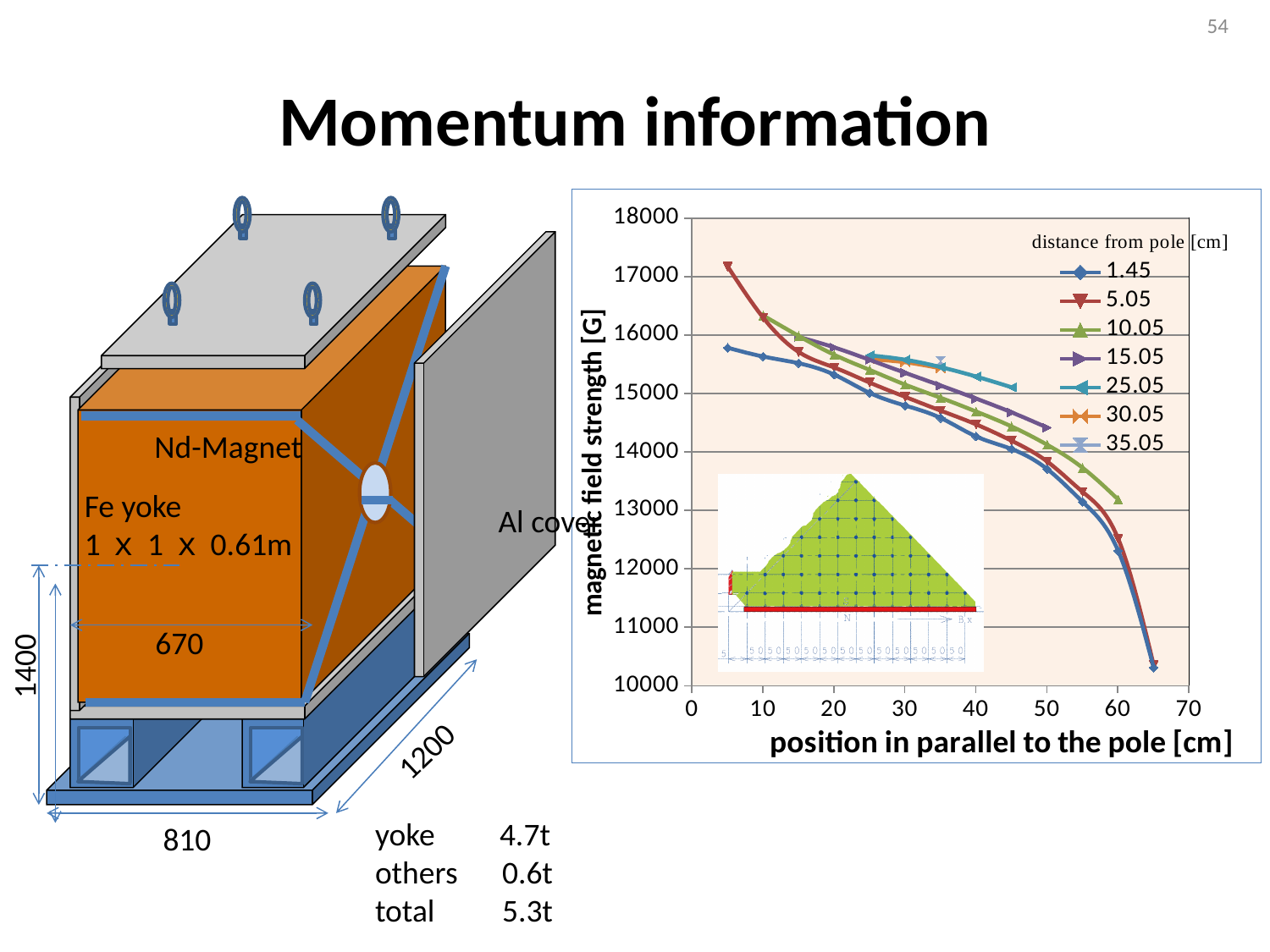
Is the value of the 15.05 series at position 50 cm greater or less than 14000? greater At position 5 cm, which series has the larger value: 5.05 or 1.45? 5.05 At position 40 cm, which series has the larger value: 15.05 or 5.05? 15.05 What is the label of the chart's y axis? magnetic field strength [G] Is the value of the 1.45 series at position 5 cm greater or less than 16000? less Is the value of the 5.05 series at position 5 cm greater or less than 17000? greater What kind of chart is shown on the slide? line chart What is the title of the chart's legend? distance from pole [cm] How many series does the chart legend list? 7 Do the magnetic field strength values rise or fall as the position in parallel to the pole increases? fall